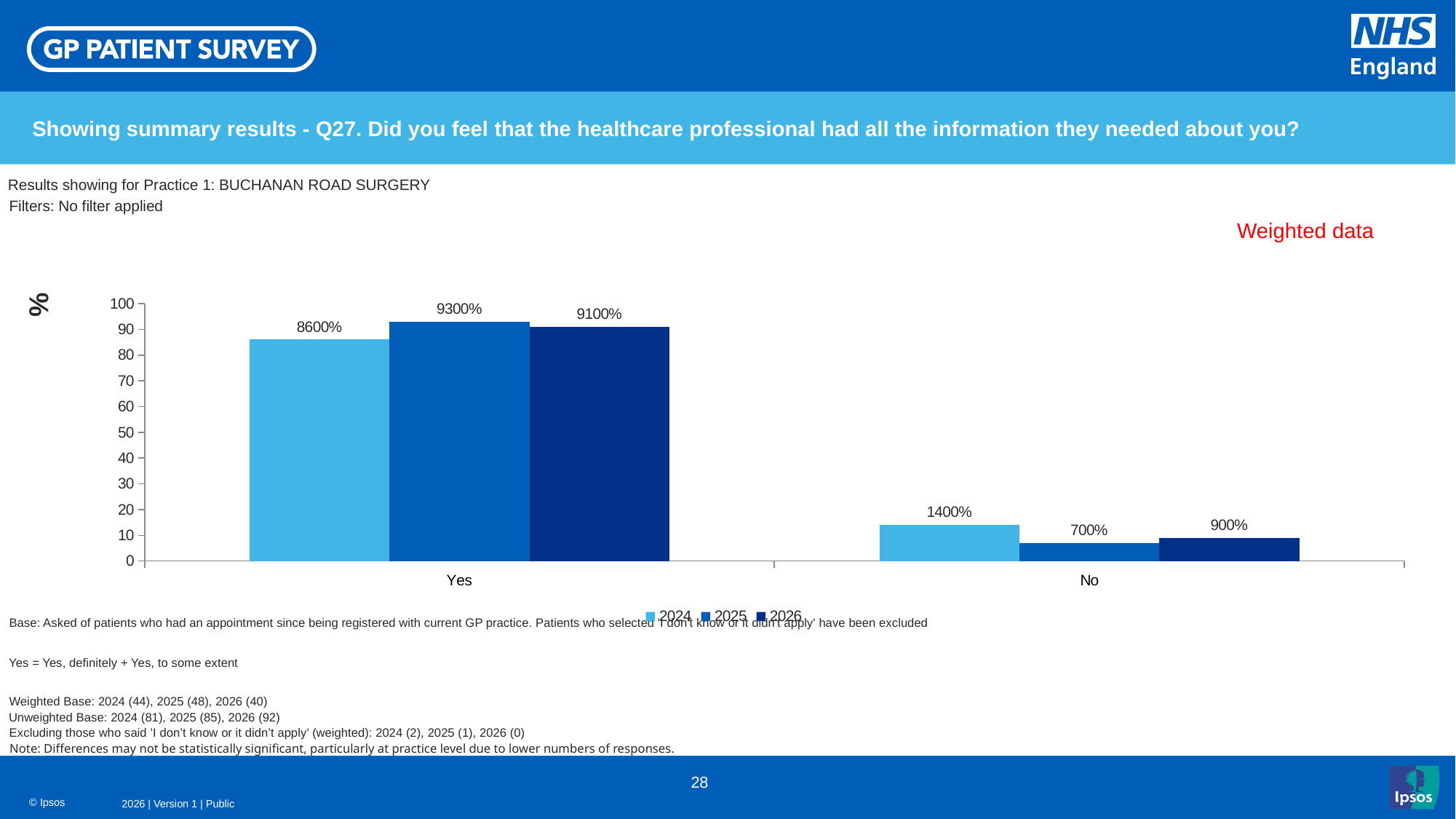
What is the label on the y axis? % How many series does the legend list? 3 What is the value for 2025 in the Yes category? 9300% How many categories are shown on the x axis? 2 What is the value for 2025 in the No category? 700% Which year has the highest value in the Yes category? 2025 What is the difference between the 2025 and 2024 values in the Yes category? 700% What kind of chart is shown on the slide? Bar chart What is the value for 2026 in the No category? 900% What is the value for 2024 in the Yes category? 8600% Which is larger: the 2024 value for No or the 2026 value for No? 2024 Which year has the lowest value in the No category? 2025